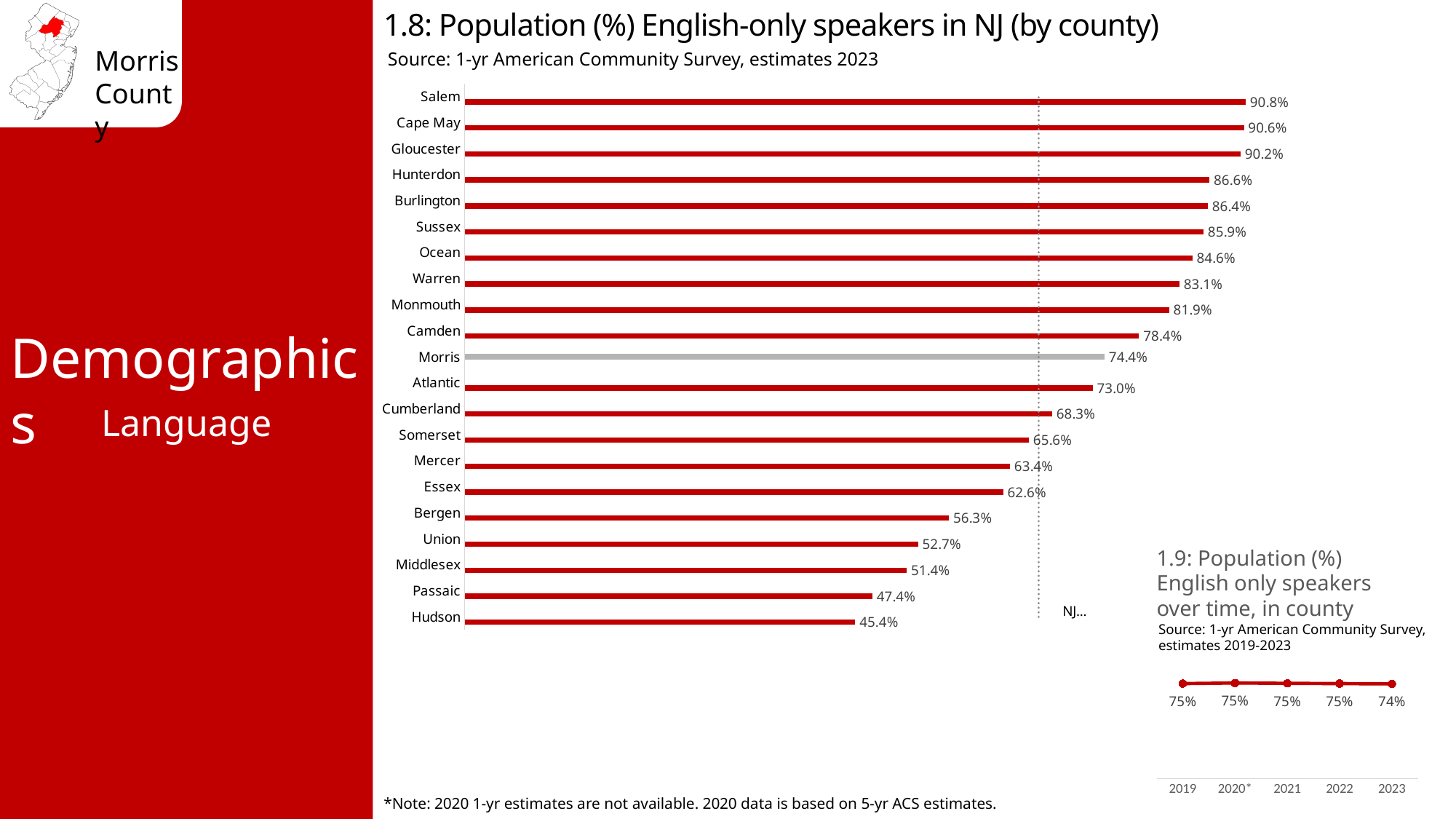
What kind of chart is chart 1.8? Bar chart In chart 1.8, what is the value for Morris? 74.4% In chart 1.8, how many counties are shown? 21 In chart 1.9, what is the value for 2023? 74% In chart 1.8, which county has the highest percentage of English-only speakers? Salem In chart 1.8, which bar is coloured grey instead of red? Morris In chart 1.8, what is the difference between the values for Camden and Morris? 4.0% In chart 1.9, how many years are plotted? 5 In chart 1.8, which is larger, the value for Bergen or the value for Union? Bergen In chart 1.8, which county has the lowest percentage of English-only speakers? Hudson In chart 1.8, what is the value for Hudson? 45.4% In chart 1.8, what is the difference between the values for Salem and Hudson? 45.4%